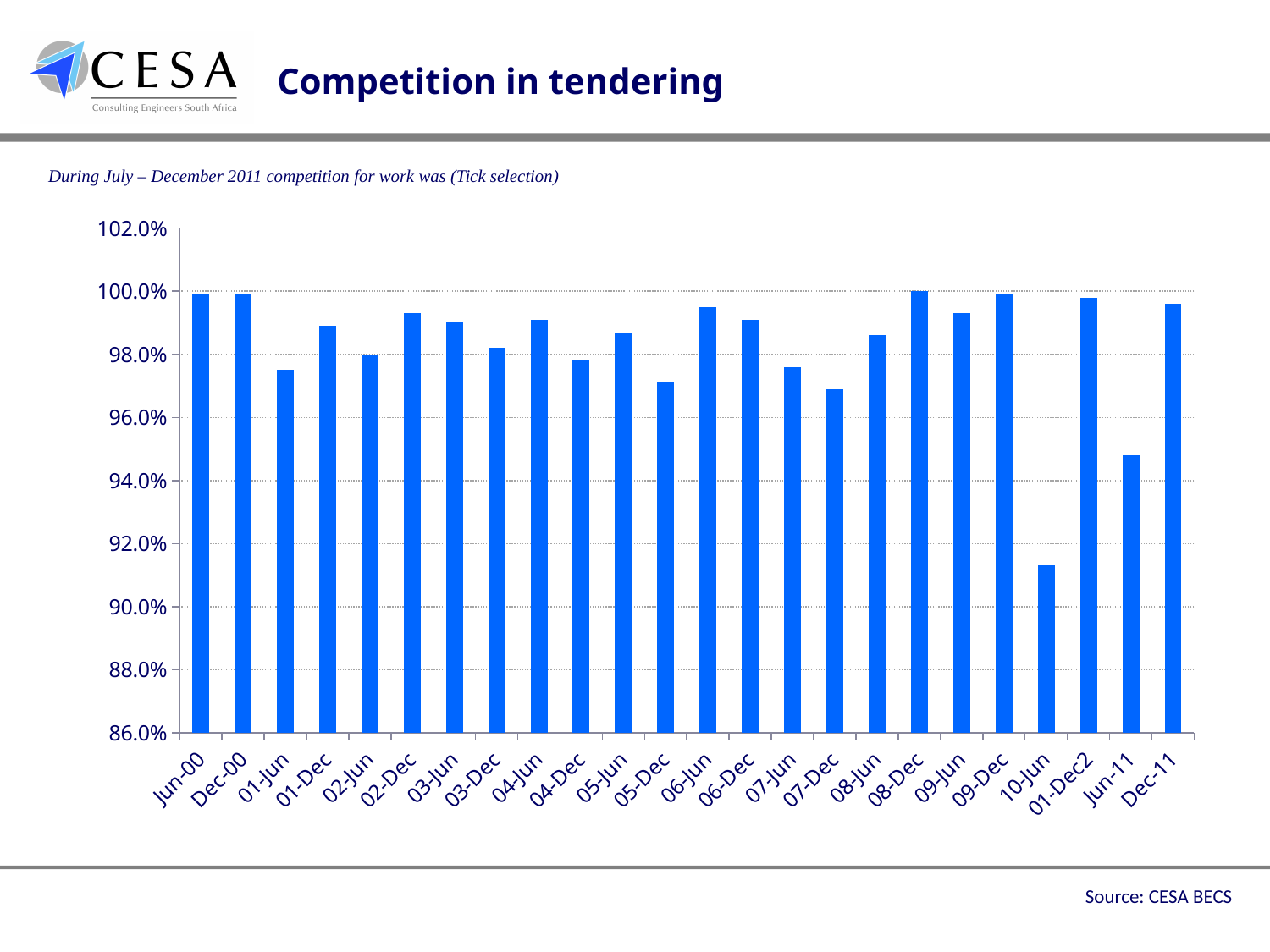
Is the value for 10-Jun greater or less than 92.0%? less How many bars (periods) are plotted in the chart? 24 Which period has the lowest value in the chart? 10-Jun What kind of chart is shown on the slide? bar chart Is the value for 07-Dec greater or less than 98.0%? less Which is larger, the value for 05-Dec or the value for 06-Jun? 06-Jun What is the lowest value shown on the vertical axis of the chart? 86.0% Which is larger, the value for 10-Jun or the value for Jun-11? Jun-11 Is the value for Dec-11 greater or less than 98.0%? greater What is the title of the slide containing the chart? Competition in tendering